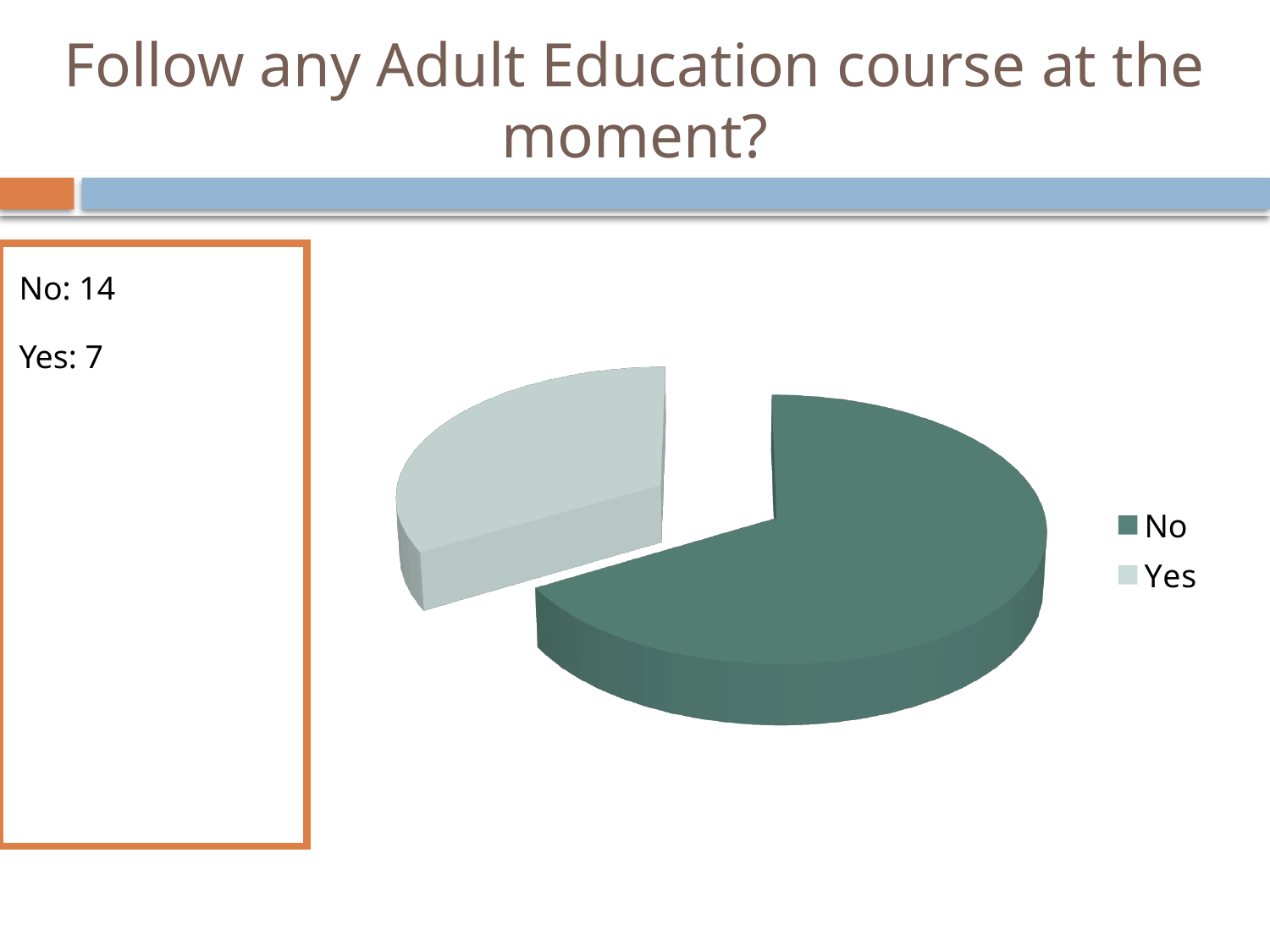
Which category has the largest slice of the pie? No What is the value for No? 14 How many entries does the legend list? 2 What is the total of the values for No and Yes? 21 What is the difference between the value for No and the value for Yes? 7 What share of the pie does the Yes slice represent? 1/3 Which category has the smallest slice of the pie? Yes Which is larger, the value for No or the value for Yes? No What is the value for Yes? 7 What is the title of the slide containing the chart? Follow any Adult Education course at the moment? How many slices does the pie chart have? 2 What kind of chart is shown on the slide? pie chart